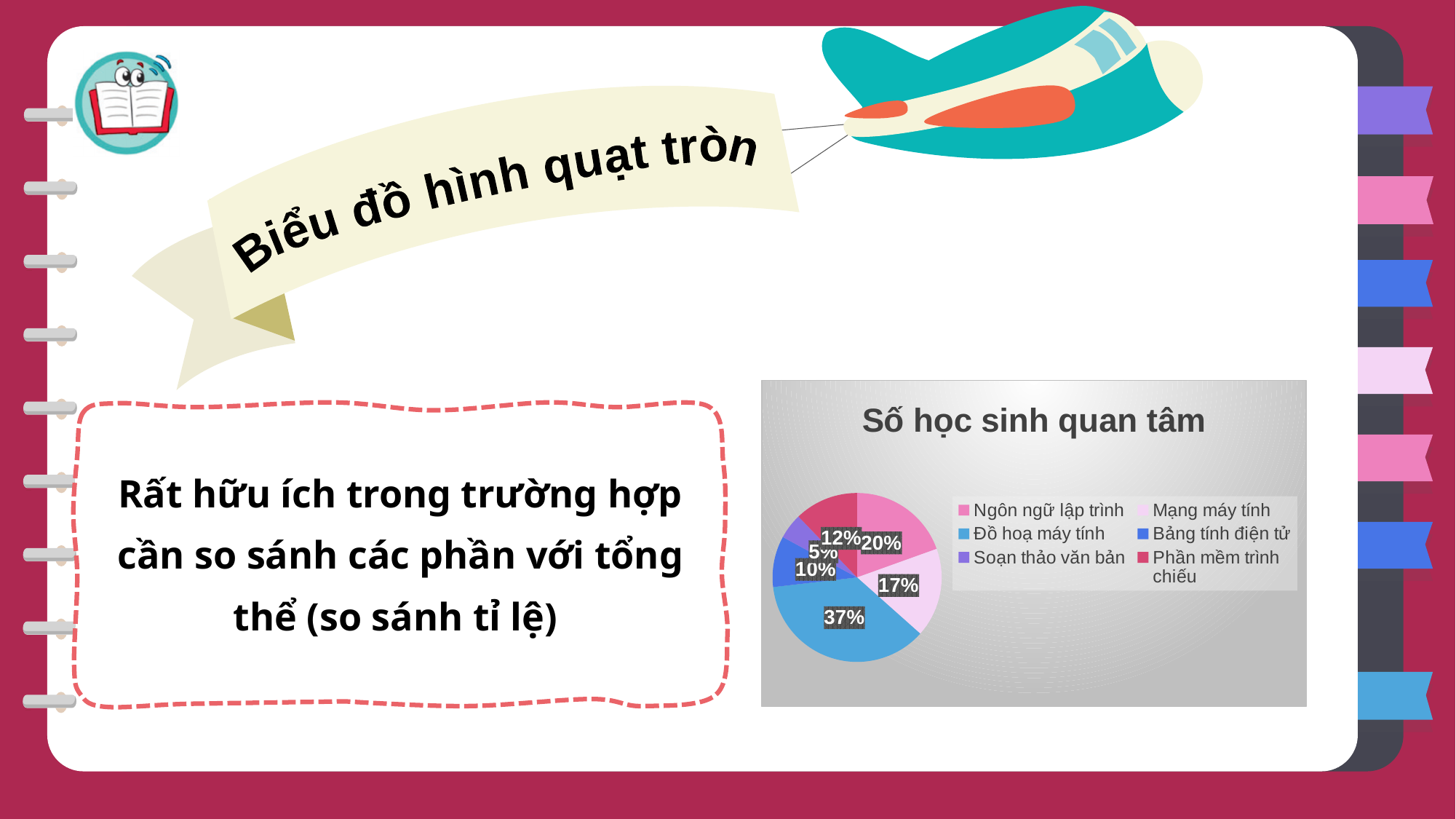
What percentage of the pie is labelled for Ngôn ngữ lập trình? 20% How many categories does the legend of the pie chart list? 6 Which slice is larger, Bảng tính điện tử or Phần mềm trình chiếu? Phần mềm trình chiếu What percentage of the pie is labelled for Mạng máy tính? 17% What percentage of the pie is labelled for Soạn thảo văn bản? 5% What is the title of the pie chart? Số học sinh quan tâm Which category has the largest slice of the pie? Đồ hoạ máy tính What kind of chart is shown on the slide? Pie chart What percentage of the pie is labelled for Phần mềm trình chiếu? 12% Which category has the smallest slice of the pie? Soạn thảo văn bản What is the difference in percentage points between the Đồ hoạ máy tính slice and the Ngôn ngữ lập trình slice? 17 What percentage of the pie is labelled for Đồ hoạ máy tính? 37%